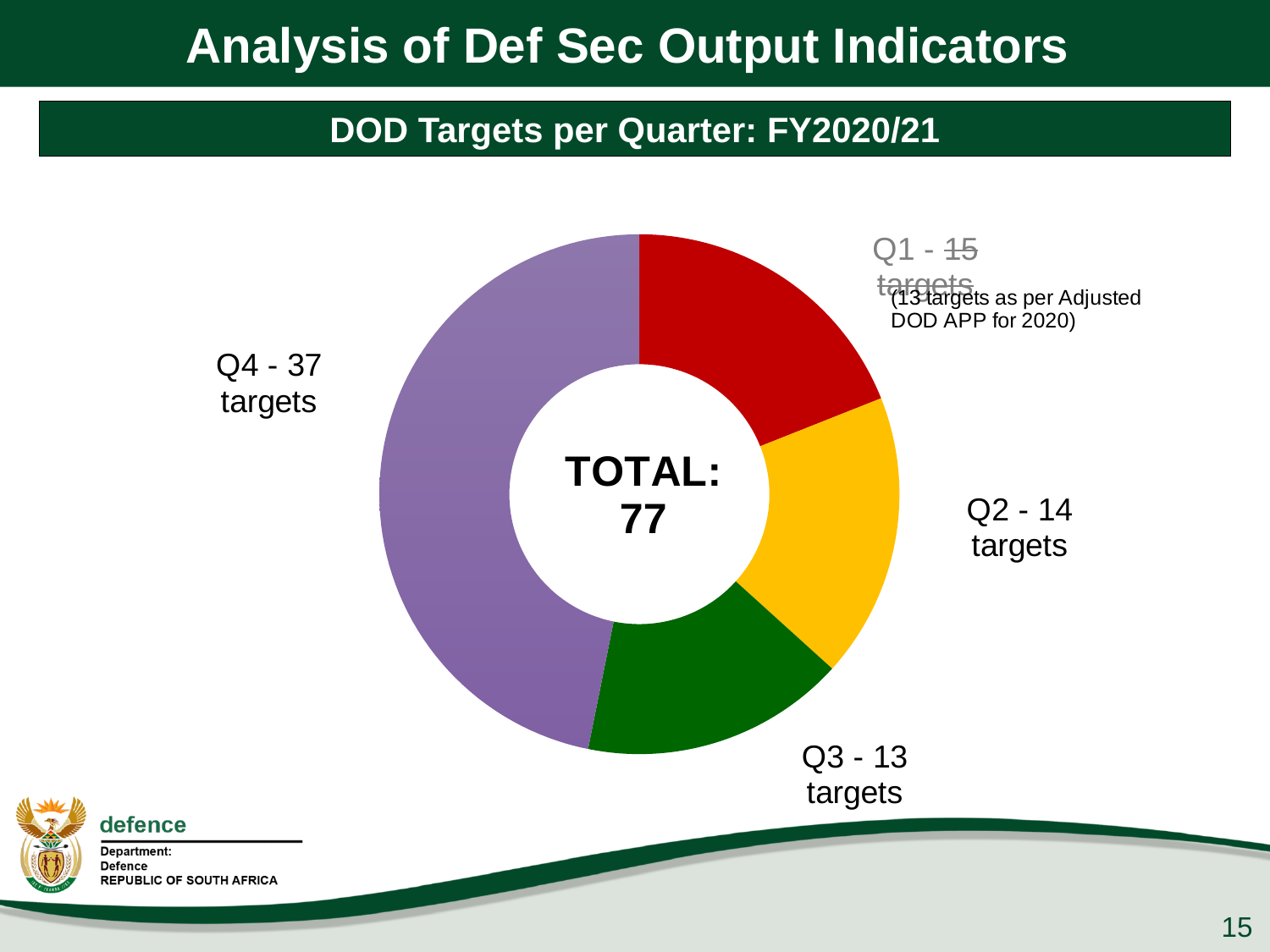
What is the difference between the number of targets in Q4 and Q3? 24 How many targets are shown for Q3? 13 targets Which quarter has more targets, Q2 or Q3? Q2 How many quarters are shown in the chart? 4 What is the total number of DOD targets shown in the centre of the chart? 77 What kind of chart is shown on the slide? pie chart (donut) According to the note next to Q1, how many Q1 targets are there as per the Adjusted DOD APP for 2020? 13 targets How many targets are shown for Q2? 14 targets What colour is the Q4 slice of the chart? purple How many targets are shown for Q4? 37 targets Which quarter has the highest number of targets? Q4 What is the difference between the number of targets in Q4 and Q2? 23